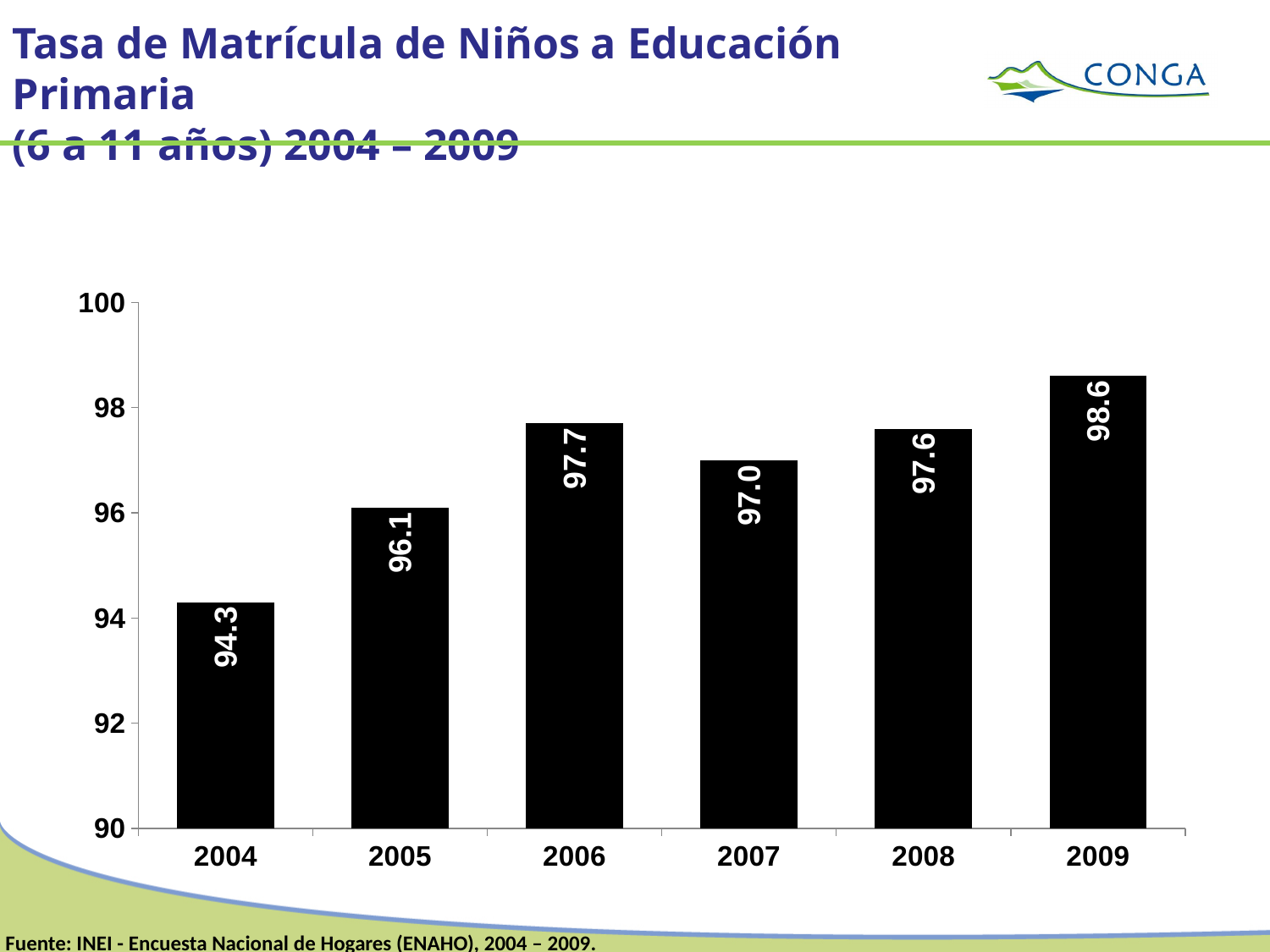
How many years are shown on the x axis? 6 Which is larger, the value for 2006 or the value for 2008? 2006 What is the difference between the values for 2006 and 2007? 0.7 What is the value for 2007? 97.0 Does the value rise or fall from 2006 to 2007? fall Which year has the highest value? 2009 What is the difference between the values for 2009 and 2004? 4.3 What kind of chart is shown on the slide? bar chart Is the value for 2005 greater or less than 96? greater What is the value for 2004? 94.3 What is the value for 2009? 98.6 Which year has the lowest value? 2004